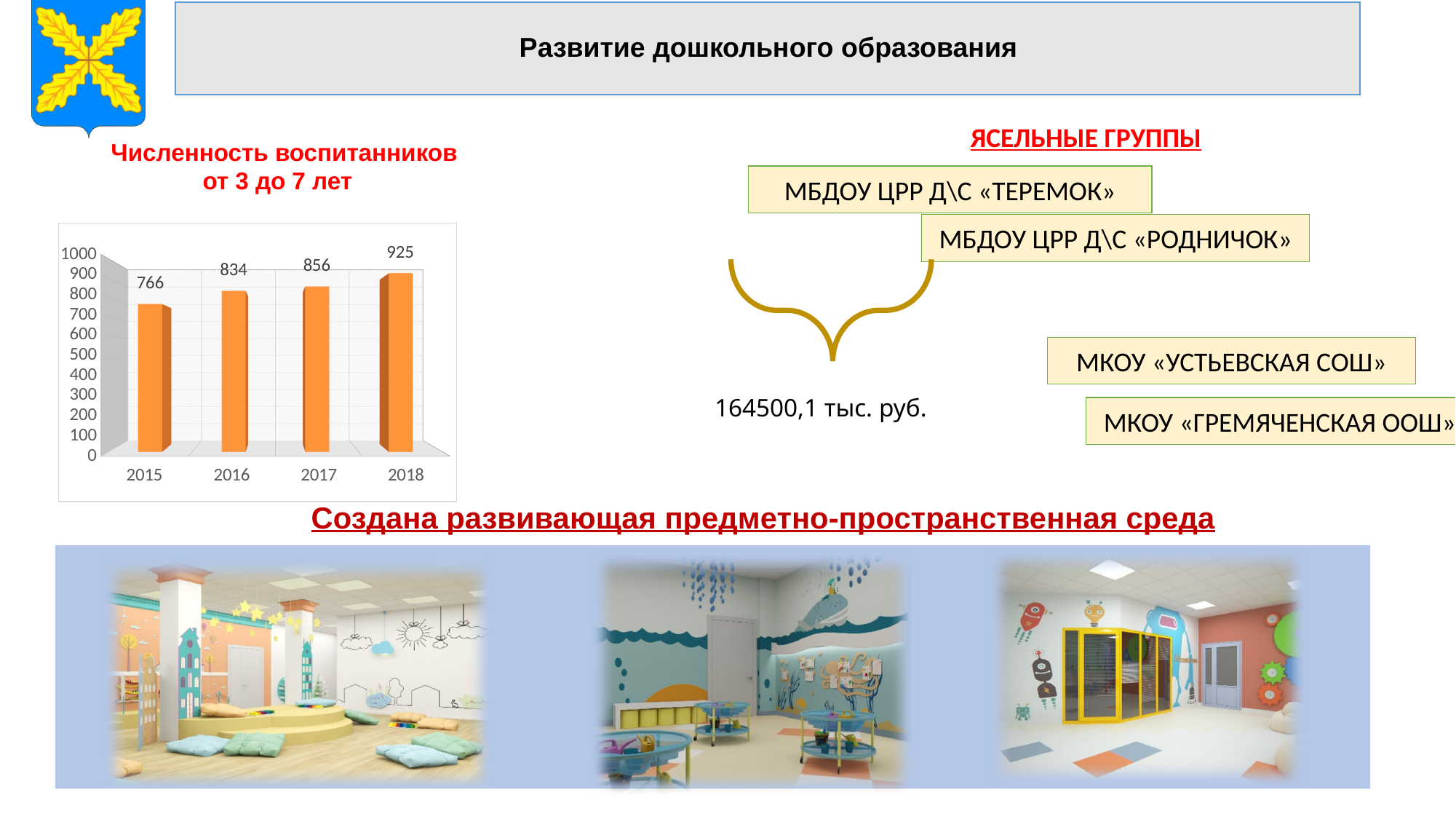
What is the value for 2017 in the chart? 856 How many years are shown on the x axis of the chart? 4 Which is larger, the value for 2016 or the value for 2017? 2017 What is the value for 2015 in the chart? 766 Is the value for 2018 greater or less than 900? greater Which year has the lowest value in the chart? 2015 What kind of chart is shown on the slide? bar chart What is the difference between the values for 2018 and 2015? 159 What is the difference between the values for 2017 and 2016? 22 Which year has the highest value in the chart? 2018 What is the value for 2018 in the chart? 925 Do the values rise or fall from 2015 to 2018? rise